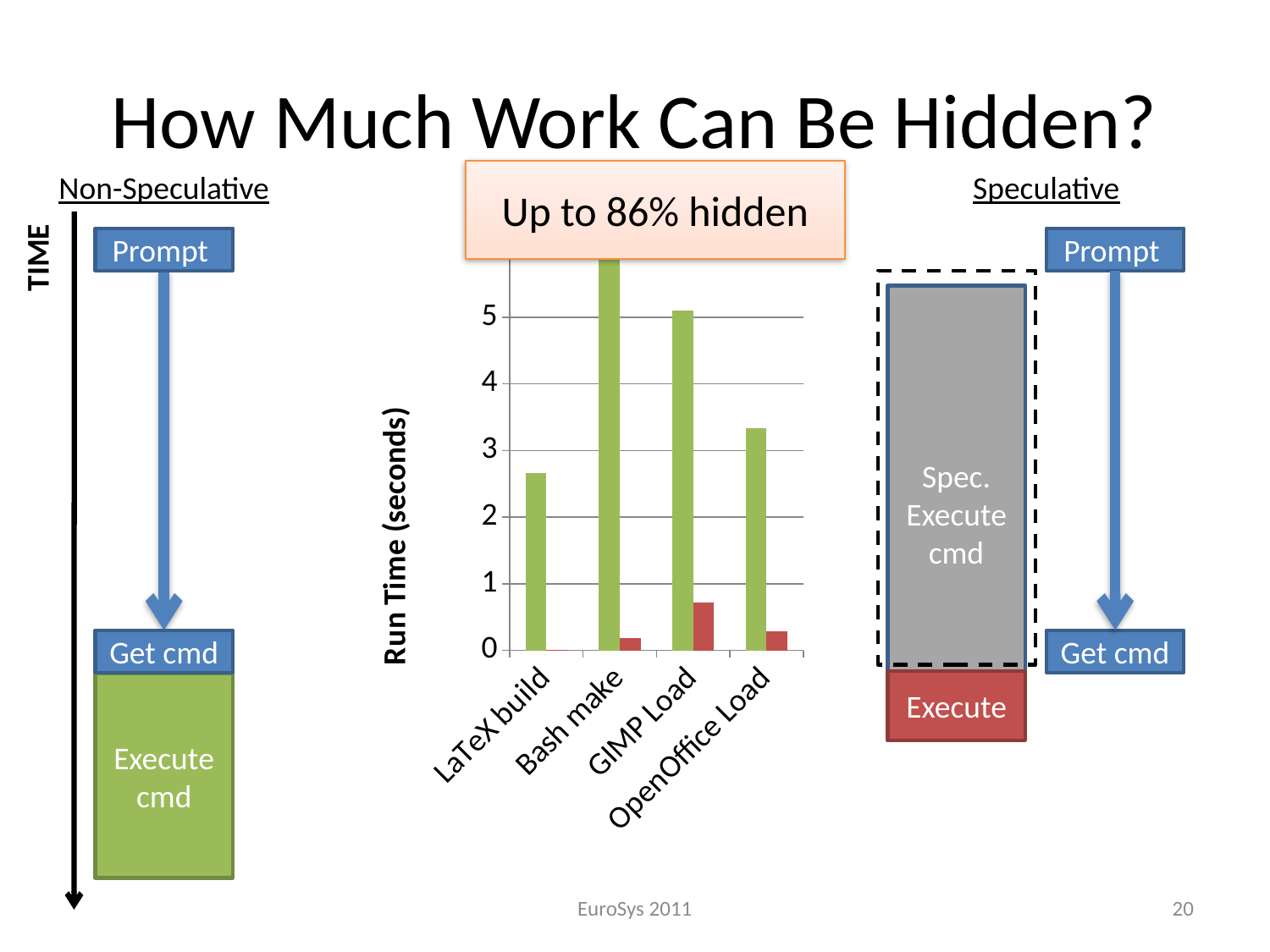
Is the green bar for OpenOffice Load greater or less than 3? greater Is the green bar for LaTeX build greater or less than 3? less Which is larger, the red bar for GIMP Load or the red bar for Bash make? GIMP Load How many categories are shown on the x axis of the bar chart? 4 Which is larger, the green bar for OpenOffice Load or the green bar for LaTeX build? OpenOffice Load Which category has the shortest green bar? LaTeX build What is the label of the y axis of the bar chart? Run Time (seconds) Is the red bar for GIMP Load greater or less than 1? less What kind of chart is shown in the middle of the slide? bar chart Which category has the tallest green bar? Bash make Which category has the tallest red bar? GIMP Load